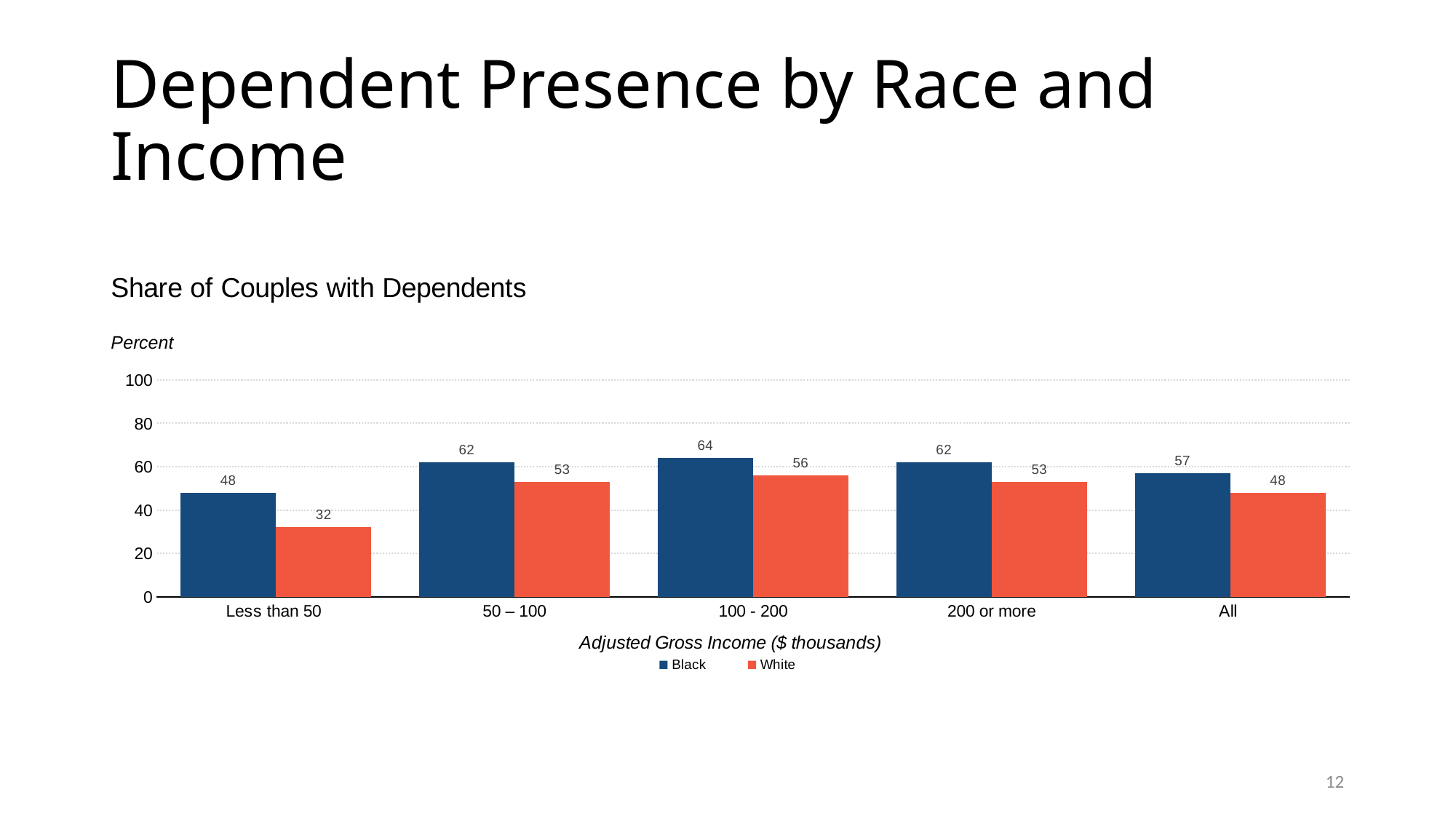
What is the value for White couples in the 100 - 200 income group? 56 What is the difference between the Black and White values in the 200 or more income group? 9 What is the difference between the Black and White values in the Less than 50 income group? 16 Which is larger in the 50 – 100 income group, the Black value or the White value? Black Which income group has the lowest value for White couples? Less than 50 Is the value for White couples in the Less than 50 income group greater or less than 40? less What is the value for Black couples in the Less than 50 income group? 48 What kind of chart is shown on the slide? bar chart Which income group has the highest value for Black couples? 100 - 200 How many income categories are shown on the x axis? 5 What is the value for White couples in the All category? 48 How many series does the legend list? 2